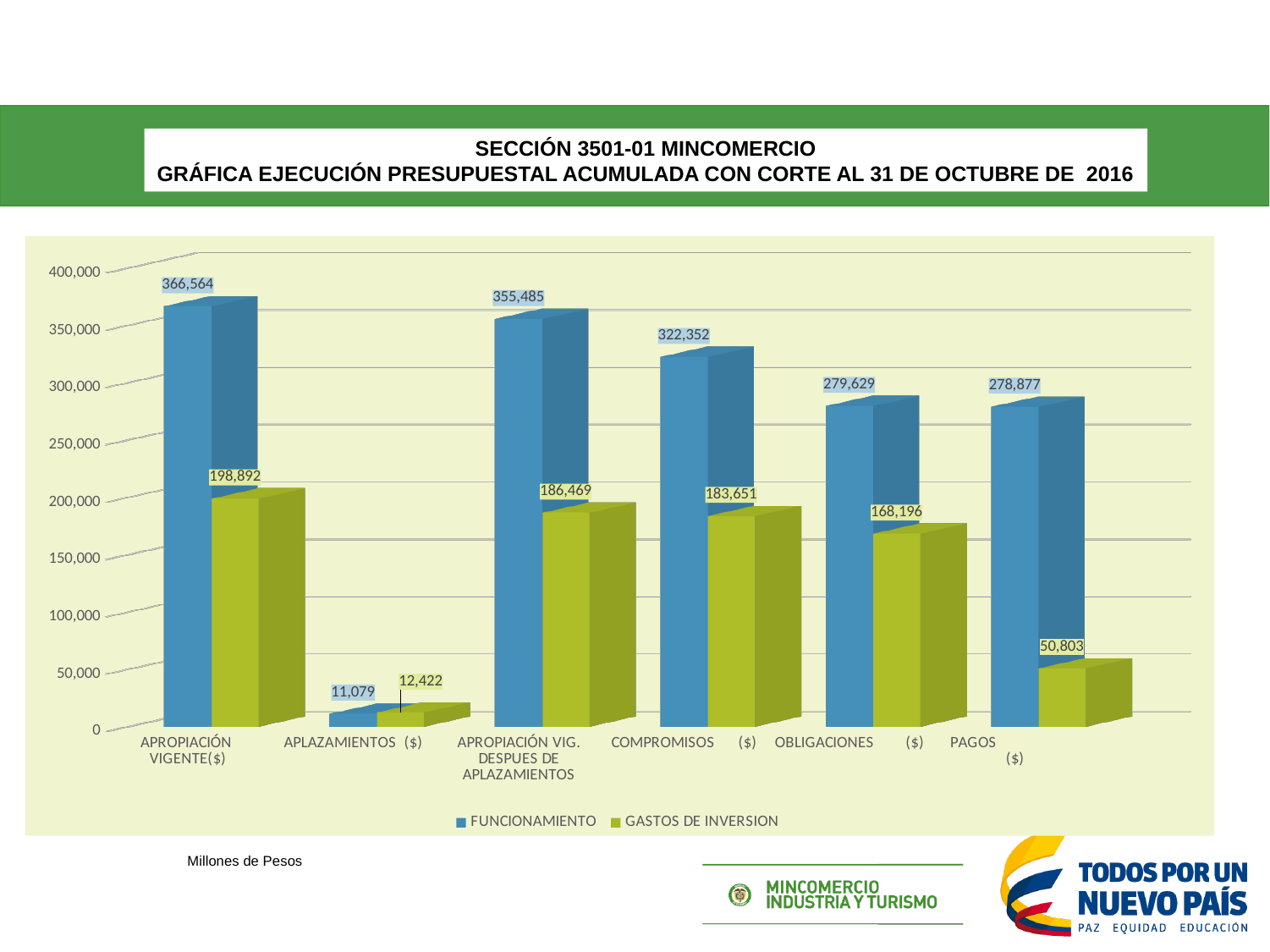
How many series does the legend list? 2 What is the difference between the FUNCIONAMIENTO values for APROPIACIÓN VIGENTE($) and APROPIACIÓN VIG. DESPUES DE APLAZAMIENTOS? 11,079 Which category has the highest GASTOS DE INVERSION value? APROPIACIÓN VIGENTE($) How many categories are shown on the x axis? 6 Which category has the lowest FUNCIONAMIENTO value? APLAZAMIENTOS ($) For COMPROMISOS ($), which series has the larger value, FUNCIONAMIENTO or GASTOS DE INVERSION? FUNCIONAMIENTO What is the GASTOS DE INVERSION value for OBLIGACIONES ($)? 168,196 What is the FUNCIONAMIENTO value for COMPROMISOS ($)? 322,352 What is the FUNCIONAMIENTO value for APROPIACIÓN VIGENTE($)? 366,564 Which colour represents the GASTOS DE INVERSION series? Green What is the GASTOS DE INVERSION value for PAGOS ($)? 50,803 What type of chart is shown on the slide? Bar chart